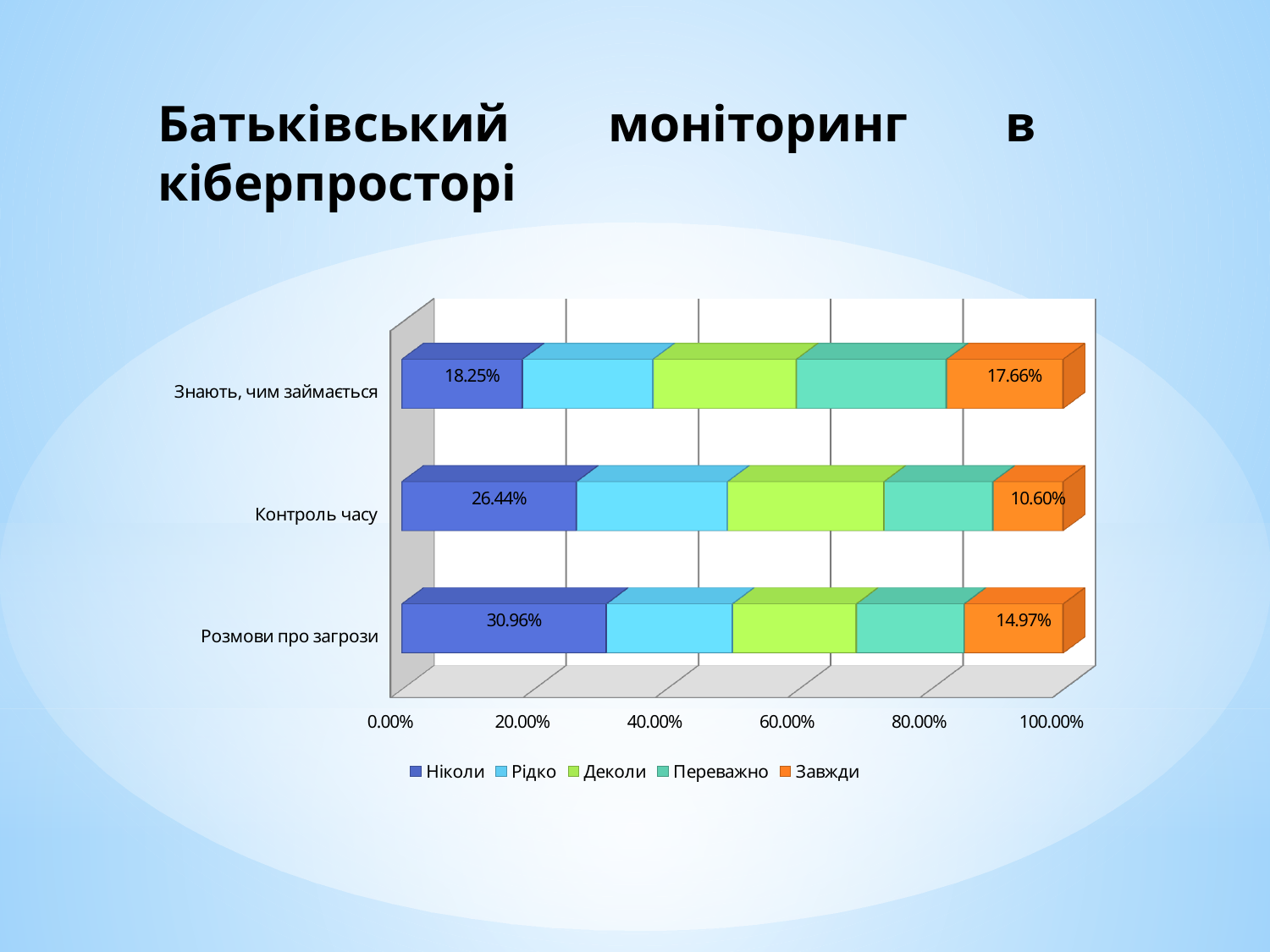
What is the value of the Завжди series for Контроль часу? 10.60% What is the difference between the Ніколи values for Розмови про загрози and Знають, чим займається? 12.71% Which category has the lowest value for the Завжди series? Контроль часу How many categories are shown on the chart? 3 What is the value of the Завжди series for Знають, чим займається? 17.66% How many series does the legend list? 5 What kind of chart is shown on the slide? Stacked bar chart Which series is shown in orange in the legend? Завжди What is the value of the Ніколи series for Знають, чим займається? 18.25% What is the value of the Ніколи series for Розмови про загрози? 30.96% Which is larger for Контроль часу: the Ніколи value or the Завжди value? Ніколи Which category has the highest value for the Ніколи series? Розмови про загрози